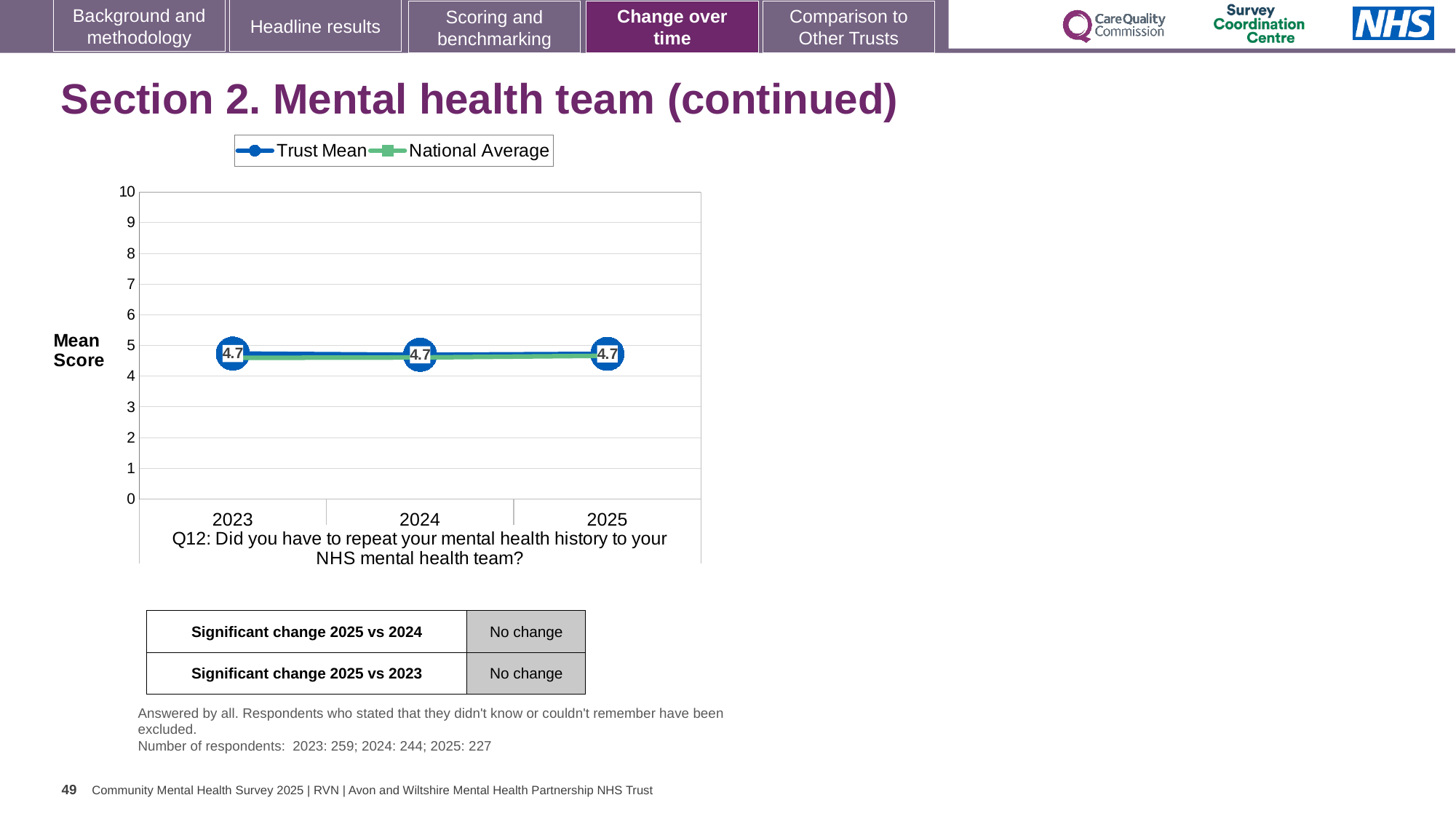
Does the Trust Mean rise, fall or stay flat from 2023 to 2025? stays flat What are the two series named in the legend? Trust Mean and National Average What is the label on the y axis of the chart? Mean Score How many years are plotted on the x axis? 3 What is the Trust Mean score for 2023? 4.7 What is the difference between the Trust Mean score in 2025 and in 2023? 0 What is the Trust Mean score for 2024? 4.7 What kind of chart is shown on the slide? line chart Is the National Average score for 2025 greater or less than 4? greater What is the Trust Mean score for 2025? 4.7 Is the Trust Mean score for 2024 greater or less than 5? less How many series does the legend list? 2